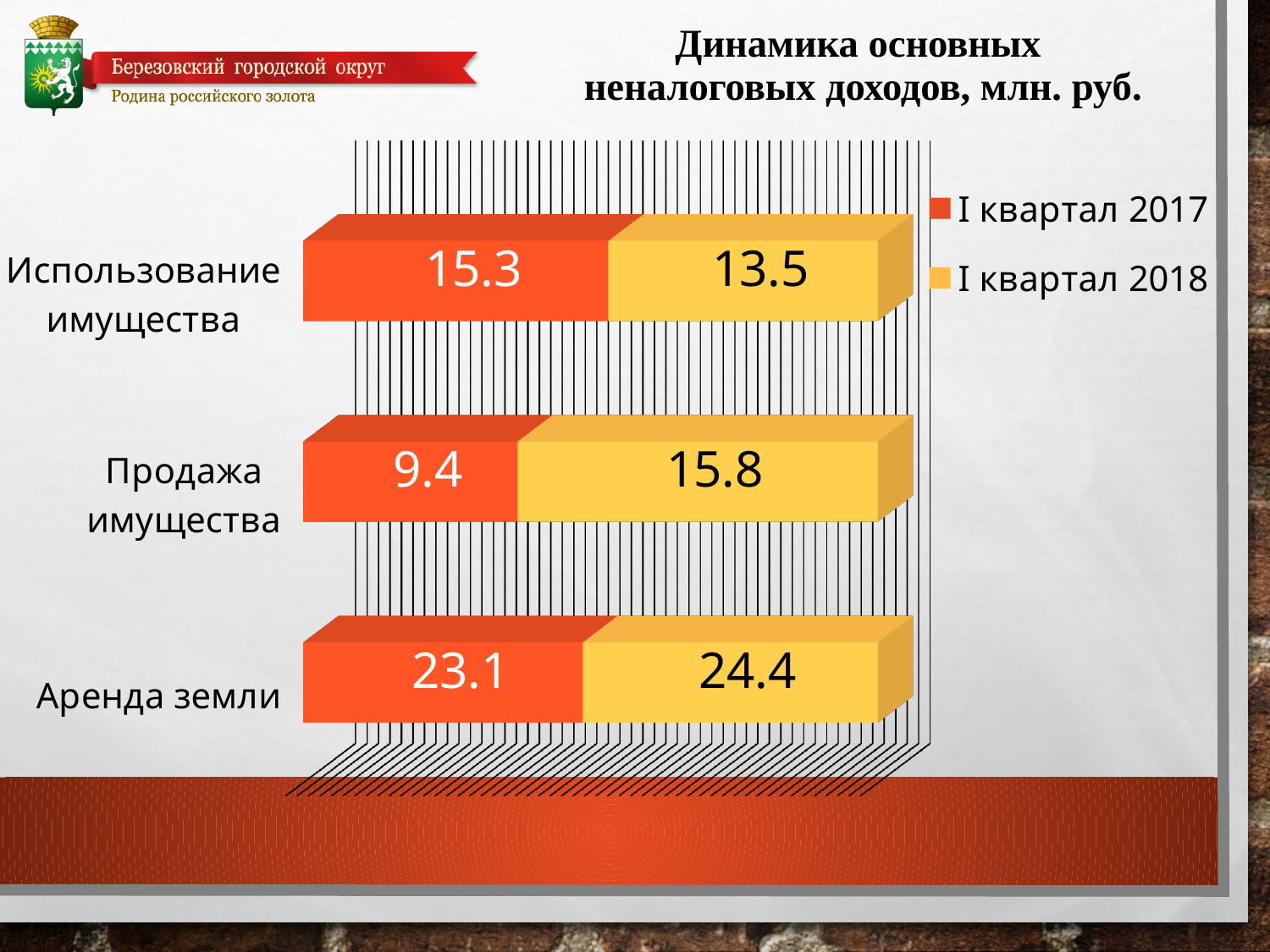
What is the value for Использование имущества in I квартал 2018? 13.5 What kind of chart is shown on the slide? Stacked bar chart How many categories are shown in the chart? 3 For Использование имущества, which is larger: the I квартал 2017 value or the I квартал 2018 value? I квартал 2017 What is the difference between the I квартал 2018 and I квартал 2017 values for Продажа имущества? 6.4 Which category has the lowest value in I квартал 2017? Продажа имущества How many series does the legend list? 2 What is the value for Продажа имущества in I квартал 2018? 15.8 What is the value for Аренда земли in I квартал 2017? 23.1 What is the title of the chart? Динамика основных неналоговых доходов, млн. руб. What is the total of the two values for Аренда земли? 47.5 Which category has the highest value in I квартал 2018? Аренда земли